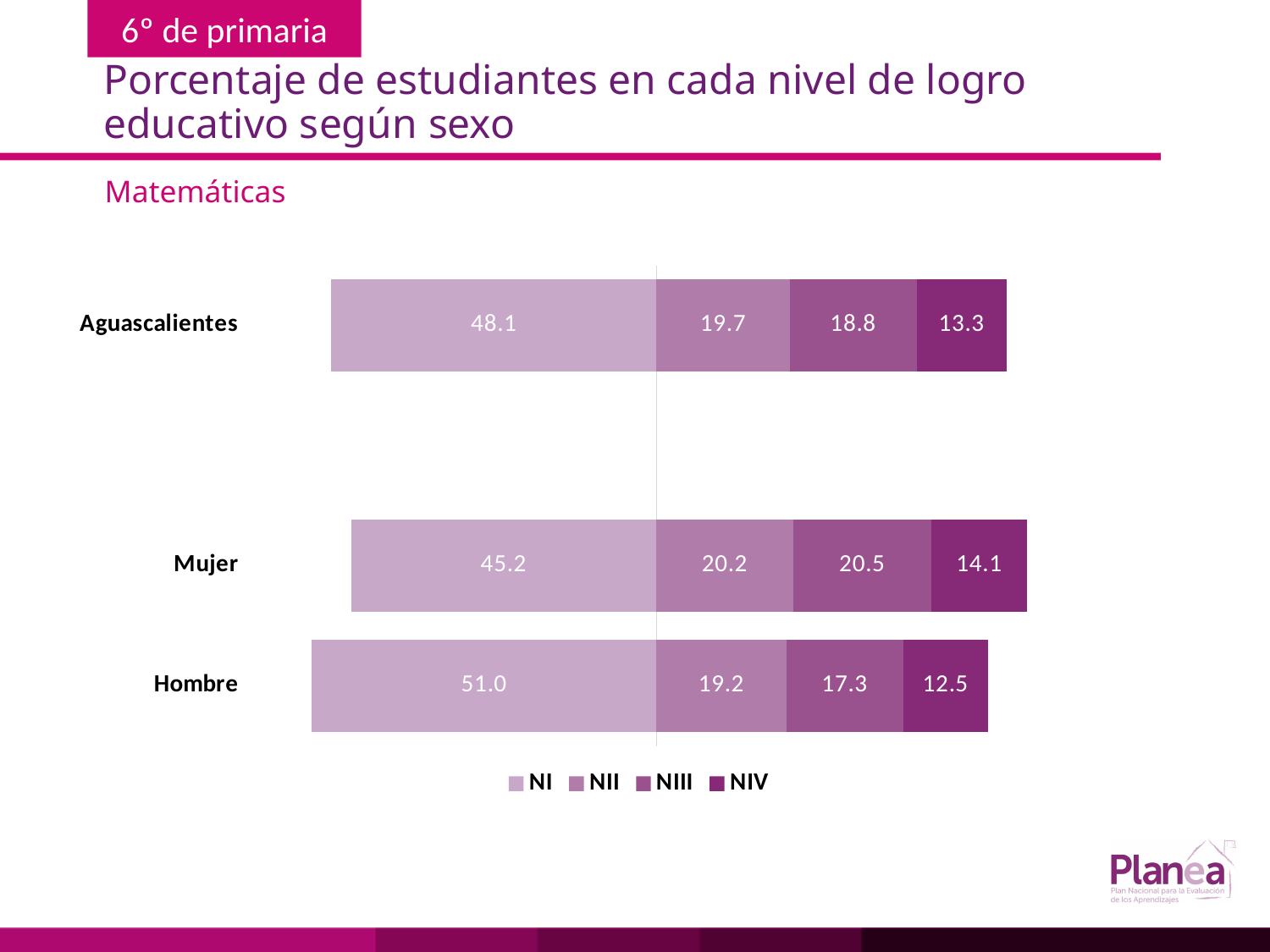
What is the difference between the NI values for Hombre and Mujer? 5.8 What is the NII value for Hombre? 19.2 How many series does the legend list? 4 Which category has the highest NI value? Hombre Which is larger, the NIII value for Mujer or the NIII value for Hombre? Mujer Which category has the lowest NIV value? Hombre What kind of chart is shown on the slide? Stacked bar chart What is the NI value for Hombre? 51.0 How many categories are shown on the chart? 3 What is the total of the stacked bar for Mujer? 100.0 What is the NIV value for Mujer? 14.1 What is the NIII value for Aguascalientes? 18.8